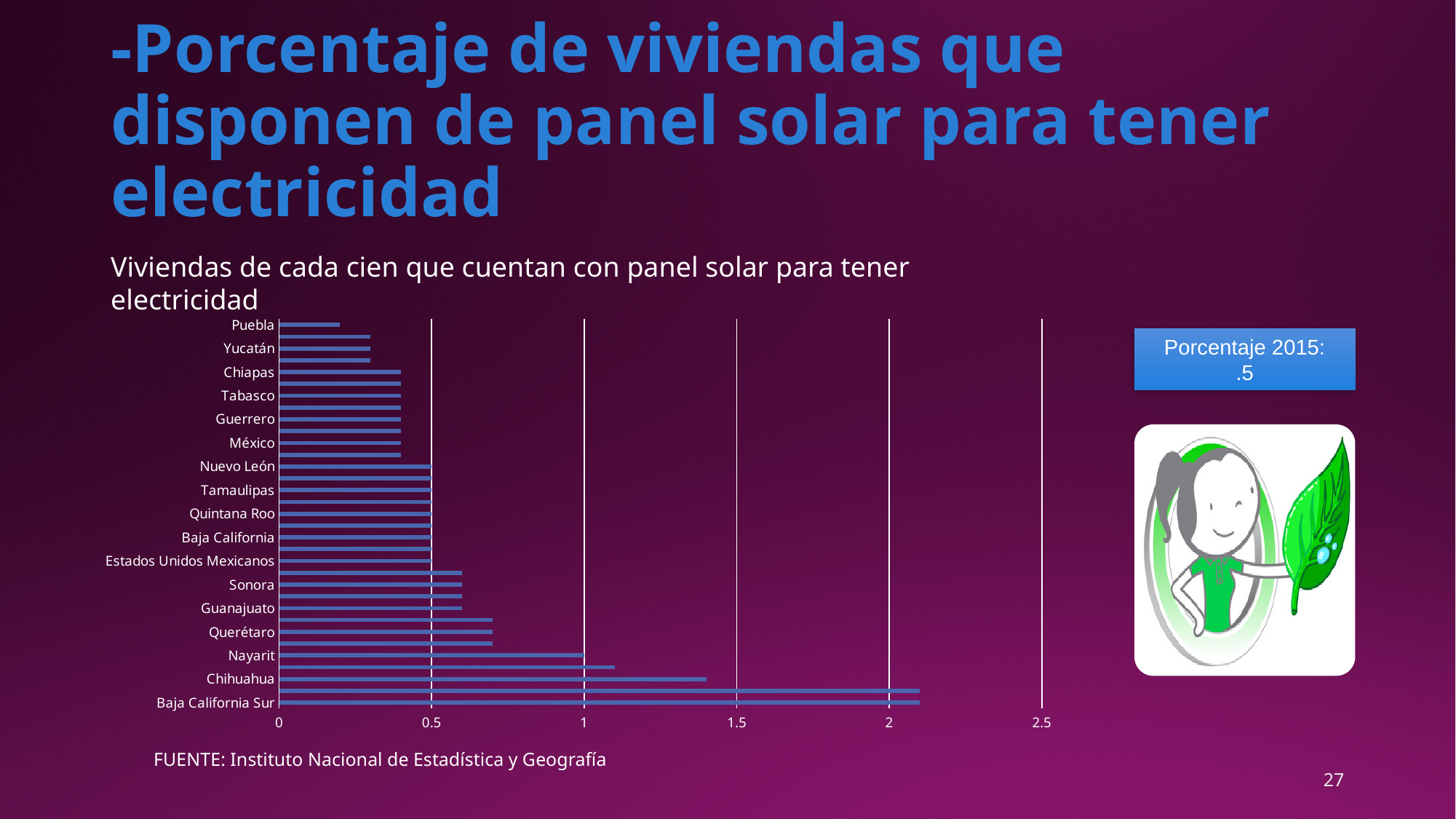
Is the value for Chihuahua greater or less than 1? greater Is the value for Puebla greater or less than 0.5? less Is the value for Yucatán greater or less than 0.5? less What source is cited below the chart? Instituto Nacional de Estadística y Geografía Which has a larger value, Chihuahua or Nayarit? Chihuahua Which category has the highest value on the chart? Baja California Sur Which category has the lowest value on the chart? Puebla What kind of chart is shown on the slide? bar chart What is the value shown for Nuevo León? 0.5 How many states/categories are listed on the chart's vertical axis? 17